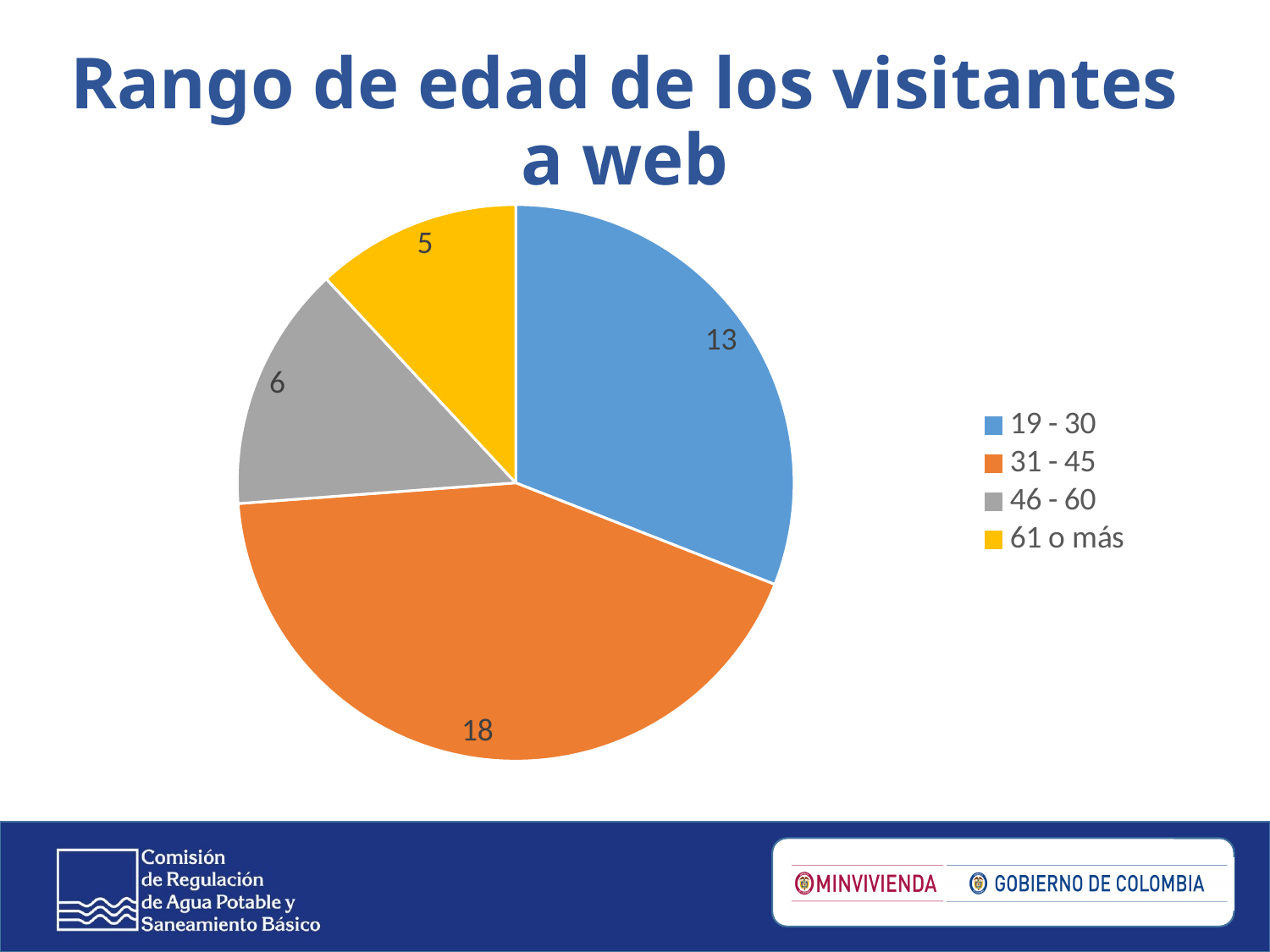
Which age range has the largest slice? 31 - 45 Which is larger, the value for 46 - 60 or the value for 61 o más? 46 - 60 What is the difference between the values for 31 - 45 and 19 - 30? 5 What is the value for the 61 o más age range? 5 How many age ranges does the legend list? 4 What is the value for the 19 - 30 age range? 13 What is the total of all the slices in the pie? 42 What is the value for the 31 - 45 age range? 18 What is the title of the chart? Rango de edad de los visitantes a web Which age range has the smallest slice? 61 o más What is the value for the 46 - 60 age range? 6 What type of chart is shown on the slide? pie chart